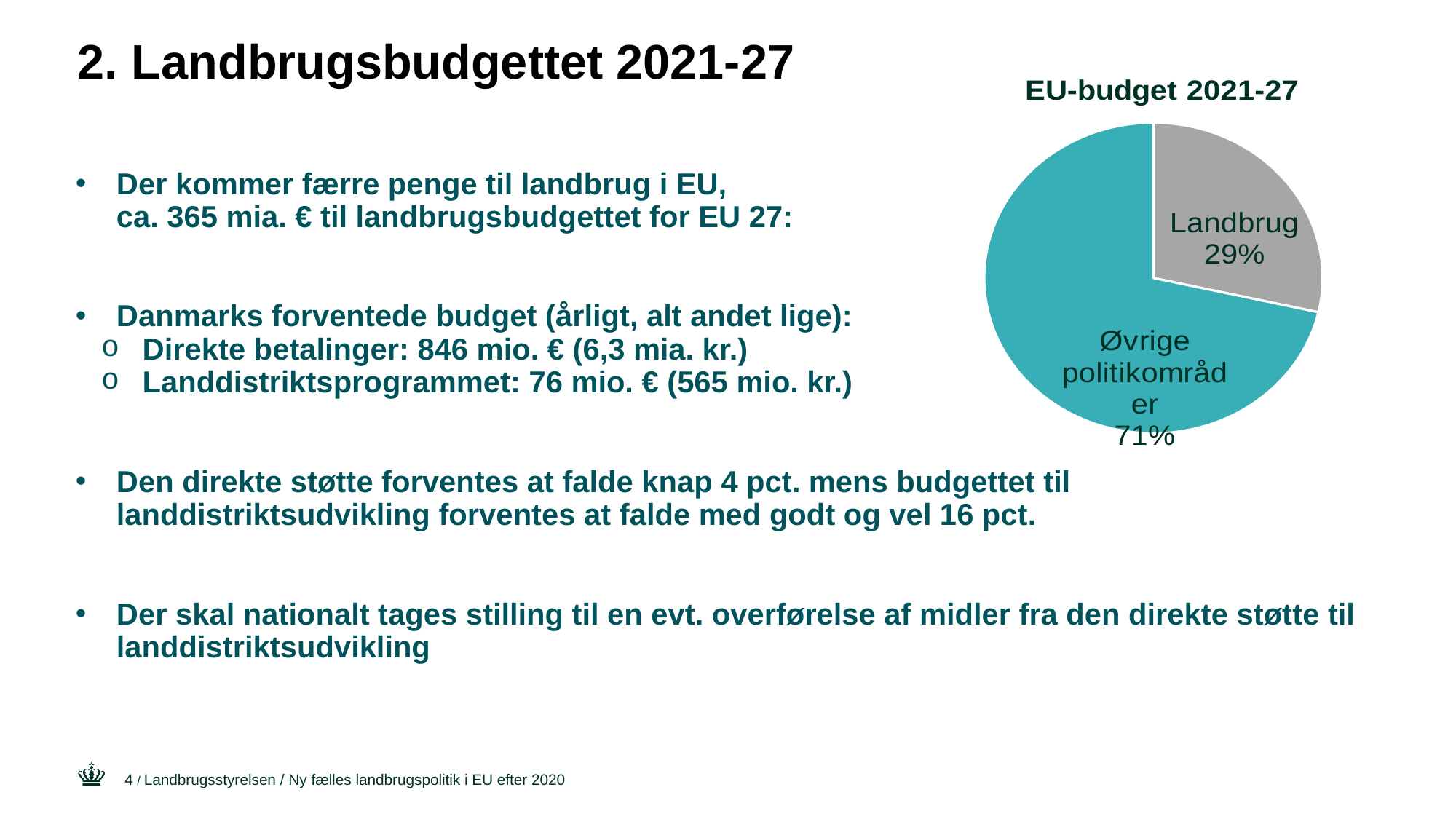
What kind of chart is shown on the slide? pie chart How many slices does the pie chart have? 2 What is the total of the two slices' percentages? 100% What is the title of the chart? EU-budget 2021-27 Which slice of the pie is the largest? Øvrige politikområder Which slice of the pie is the smallest? Landbrug What is the difference in percentage points between Øvrige politikområder and Landbrug? 42 What share of the pie does Landbrug represent? 29% What colour is the Landbrug slice? grey Which is larger, the share for Landbrug or the share for Øvrige politikområder? Øvrige politikområder What share of the pie does Øvrige politikområder represent? 71%